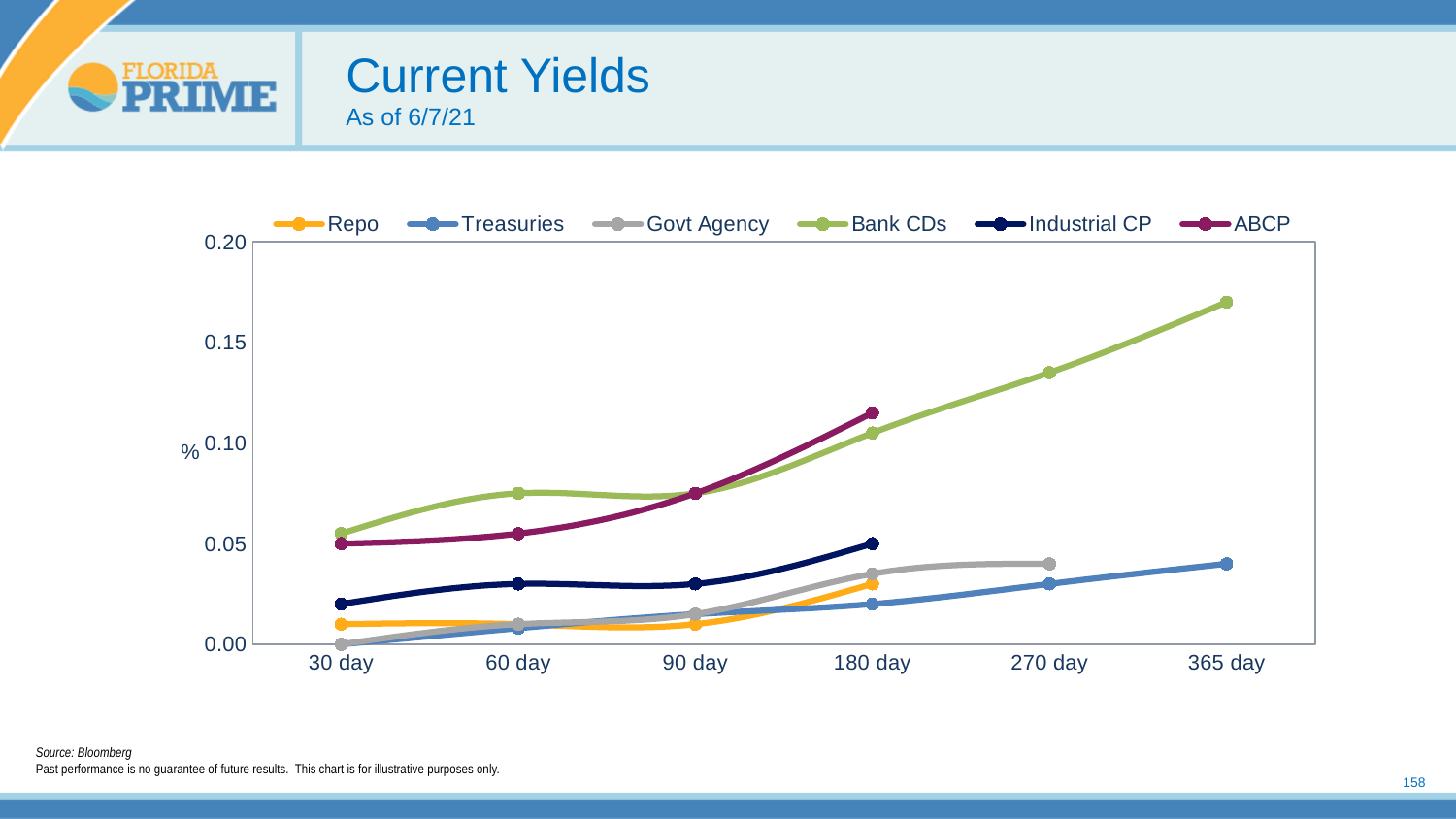
Is the value for Bank CDs at 270 day greater or less than 0.10? greater How many series does the legend list? 6 Is the value for Bank CDs at 365 day greater or less than 0.15? greater What kind of chart is shown on the slide? line chart Is the value for ABCP at 180 day greater or less than 0.10? greater How many categories are shown on the x axis? 6 What is the title of the chart? Current Yields At 90 day, which is larger: Bank CDs or Industrial CP? Bank CDs Which series has the highest value at 365 day? Bank CDs At 180 day, which is larger: Industrial CP or Repo? Industrial CP Do the values for Bank CDs rise or fall from 30 day to 365 day? rise